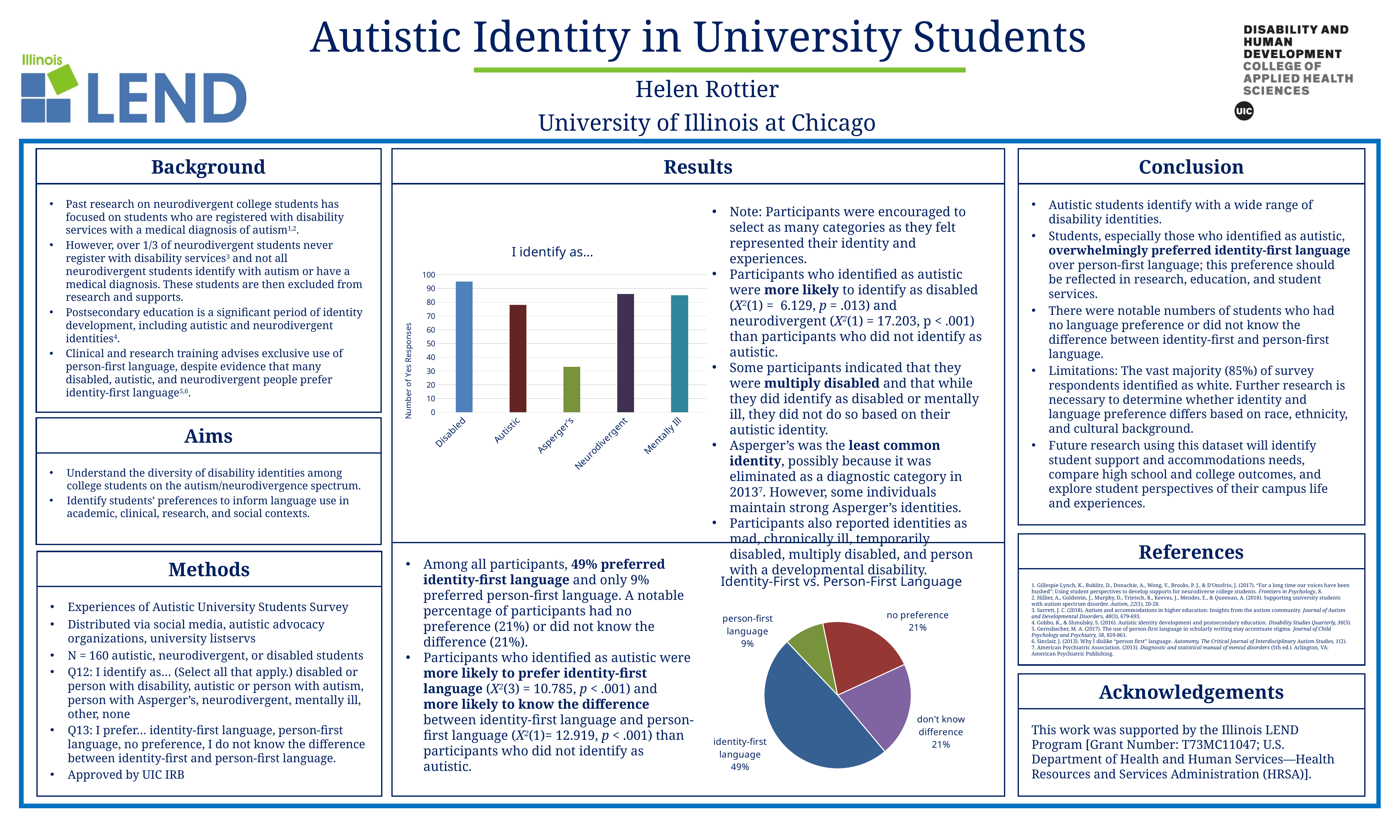
In the 'I identify as...' chart, is the value for Autistic greater or less than 70? greater What type of chart is the 'I identify as...' chart? bar chart In the 'I identify as...' chart, is the value for Asperger's greater or less than 40? less In the 'I identify as...' chart, is the value for Disabled greater or less than 90? greater In the 'Identity-First vs. Person-First Language' pie chart, what share of participants preferred identity-first language? 49% In the 'I identify as...' chart, which category has the lowest number of yes responses? Asperger's In the 'I identify as...' chart, which category has the highest number of yes responses? Disabled In the 'I identify as...' chart, how many identity categories are shown? 5 In the 'Identity-First vs. Person-First Language' pie chart, what is the difference between the identity-first language share and the person-first language share? 40% In the 'Identity-First vs. Person-First Language' pie chart, what share of participants preferred person-first language? 9% In the 'I identify as...' chart, what is the label of the vertical axis? Number of Yes Responses In the 'Identity-First vs. Person-First Language' pie chart, how many slices are there? 4